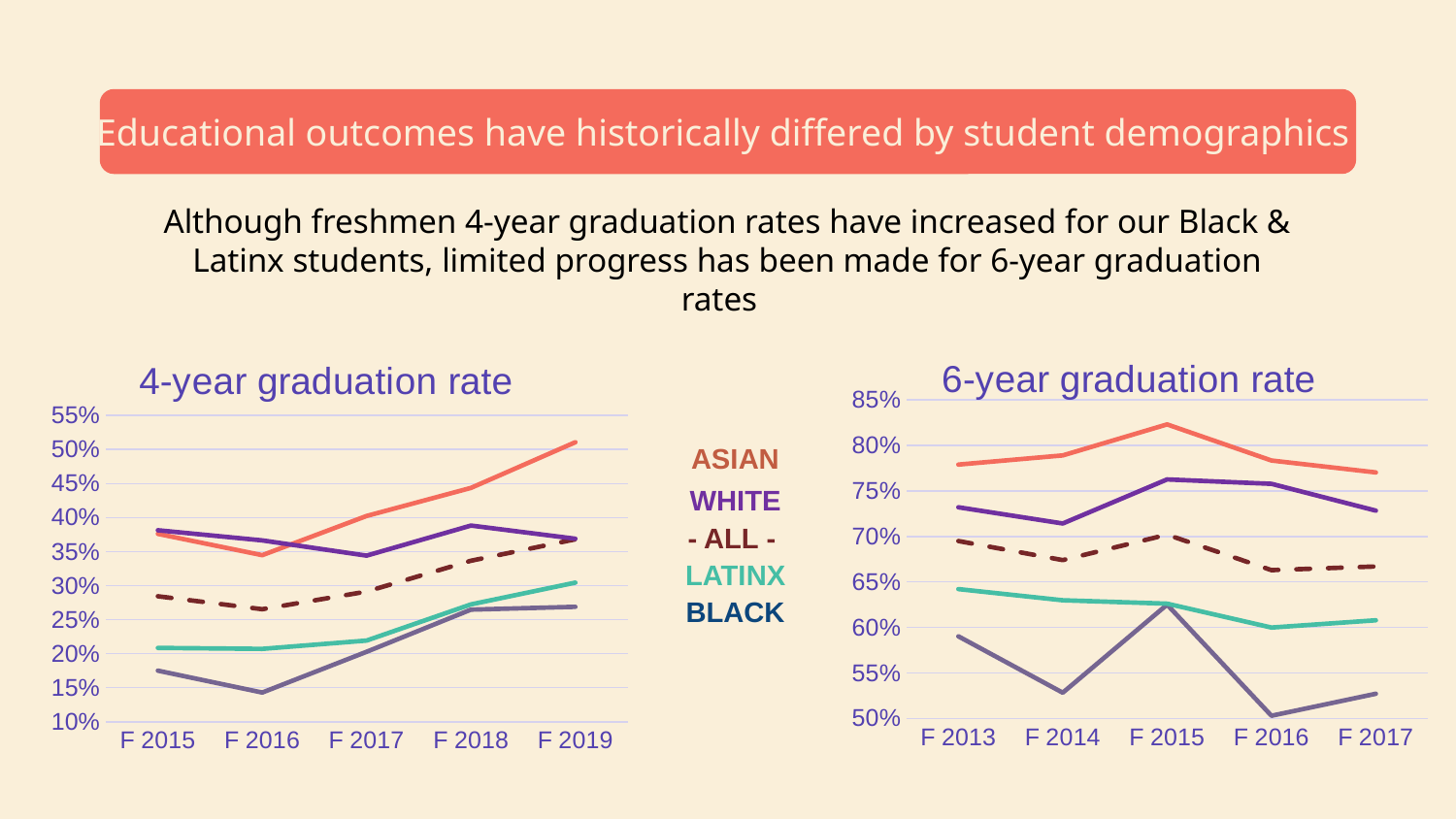
In the 4-year graduation rate chart, which group has the highest rate for F 2019? ASIAN In the 6-year graduation rate chart, which group has the highest rate for F 2015? ASIAN How many cohort years are plotted on the x axis of the 6-year graduation rate chart? 5 In the 4-year graduation rate chart, which is larger for F 2016: the WHITE value or the ASIAN value? WHITE In the 6-year graduation rate chart, which group has the lowest rate for F 2016? BLACK In the 4-year graduation rate chart, is the ASIAN value for F 2019 greater or less than 45%? greater In the 4-year graduation rate chart, does the ASIAN line rise or fall from F 2016 to F 2019? Rise In the 6-year graduation rate chart, is the BLACK value for F 2016 greater or less than 55%? less What kind of chart is the 4-year graduation rate chart? Line chart How many series does the legend list for the graduation rate charts? 5 In the 4-year graduation rate chart, which group has the lowest rate for F 2015? BLACK In the 6-year graduation rate chart, does the LATINX line rise or fall from F 2013 to F 2016? Fall